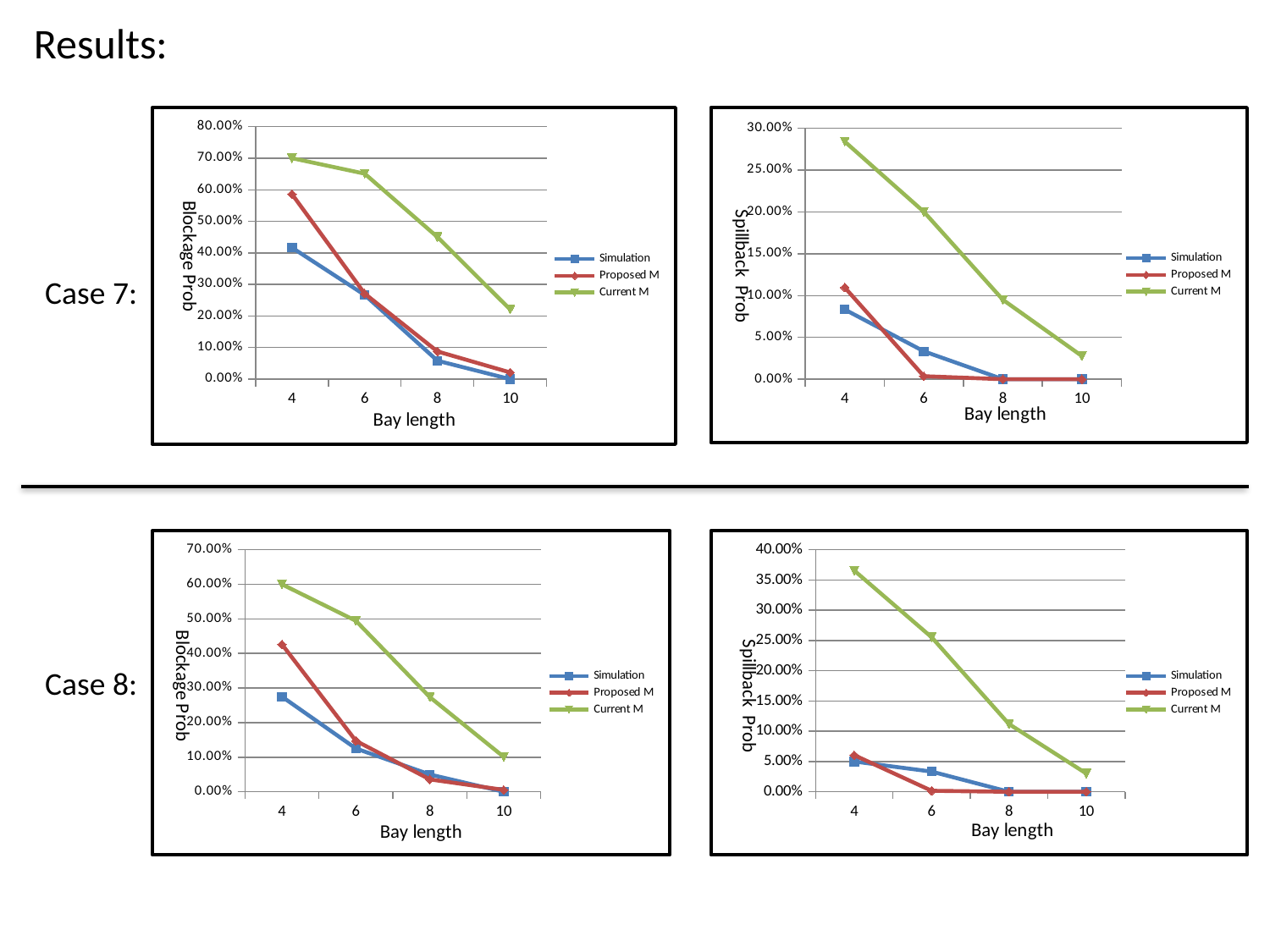
In the top-right chart (Case 7, Spillback Prob), which series has the lowest value at bay length 6? Proposed M In the bottom-left chart (Case 8, Blockage Prob), which is larger at bay length 6, Proposed M or Simulation? Proposed M In the bottom-right chart (Case 8, Spillback Prob), is the value for Current M at bay length 4 greater or less than 30%? greater How many bay length values are plotted on the x axis of the top-left chart (Case 7, Blockage Prob)? 4 In the top-left chart (Case 7, Blockage Prob), does the Current M series rise or fall as bay length increases? fall In the bottom-left chart (Case 8, Blockage Prob), is the value for Simulation at bay length 4 greater or less than 30%? less What is the x-axis title of the bottom-right chart (Case 8, Spillback Prob)? Bay length In the top-right chart (Case 7, Spillback Prob), is the value for Current M at bay length 4 greater or less than 25%? greater In the top-left chart (Case 7, Blockage Prob), which series has the highest value at bay length 4? Current M What kind of chart is the top-left chart (Case 7, Blockage Prob)? line chart How many series does the legend of the top-left chart (Case 7, Blockage Prob) list? 3